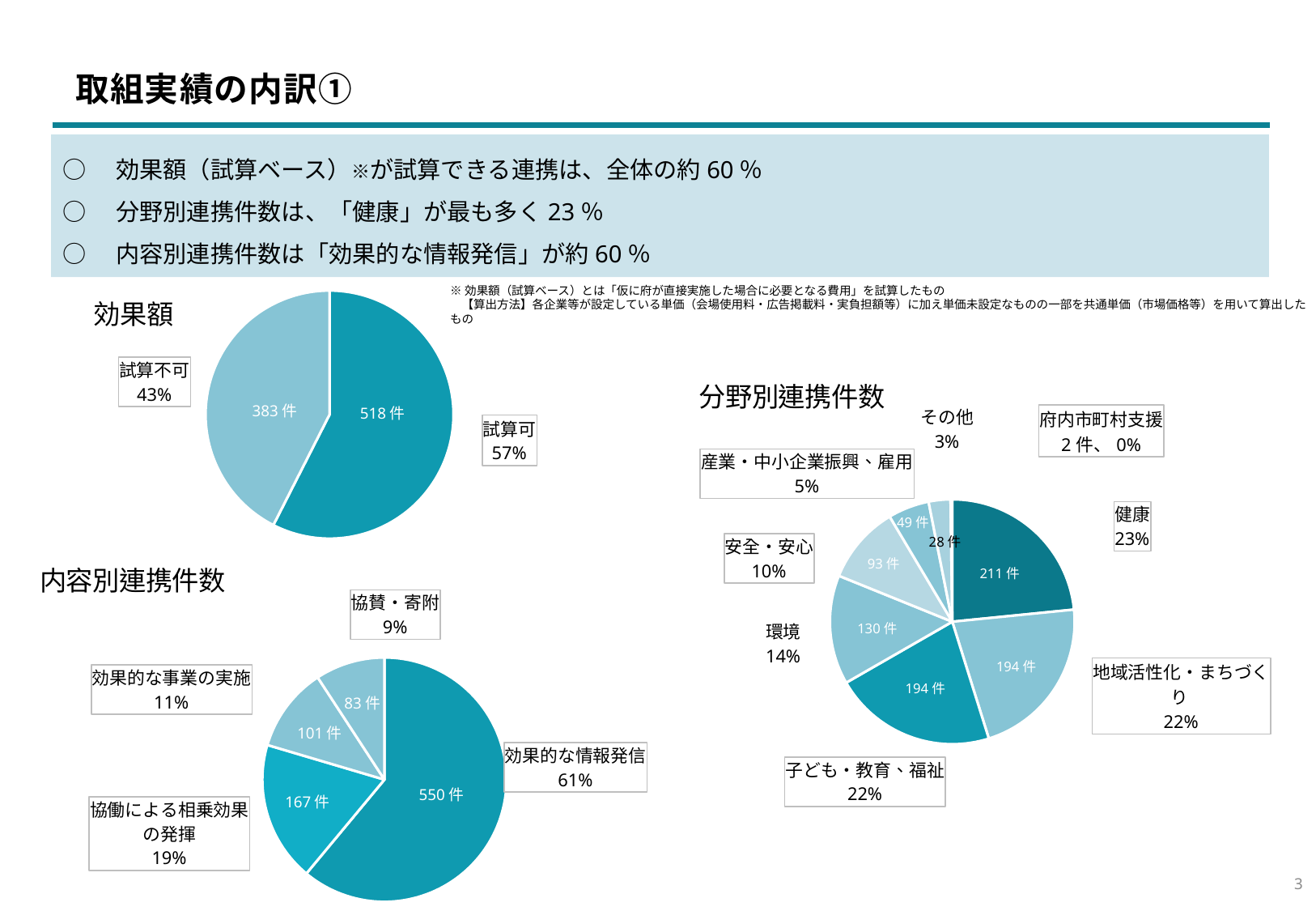
In the 内容別連携件数 chart, which category has the smallest share? 協賛・寄附 In the 効果額 chart, what share of the pie is 試算不可? 43% In the 内容別連携件数 chart, how many categories are shown? 4 In the 分野別連携件数 chart, which is larger, 環境 or 安全・安心? 環境 In the 効果額 chart, how many cases are 試算可? 518 件 In the 内容別連携件数 chart, how many cases are 効果的な情報発信? 550 件 In the 効果額 chart, what is the difference in cases between 試算可 and 試算不可? 135 件 In the 分野別連携件数 chart, how many categories are shown? 8 In the 分野別連携件数 chart, how many cases are 健康? 211 件 In the 分野別連携件数 chart, which category has the largest share? 健康 In the 内容別連携件数 chart, what share of the pie is 協働による相乗効果の発揮? 19% What kind of chart is the 効果額 chart? Pie chart